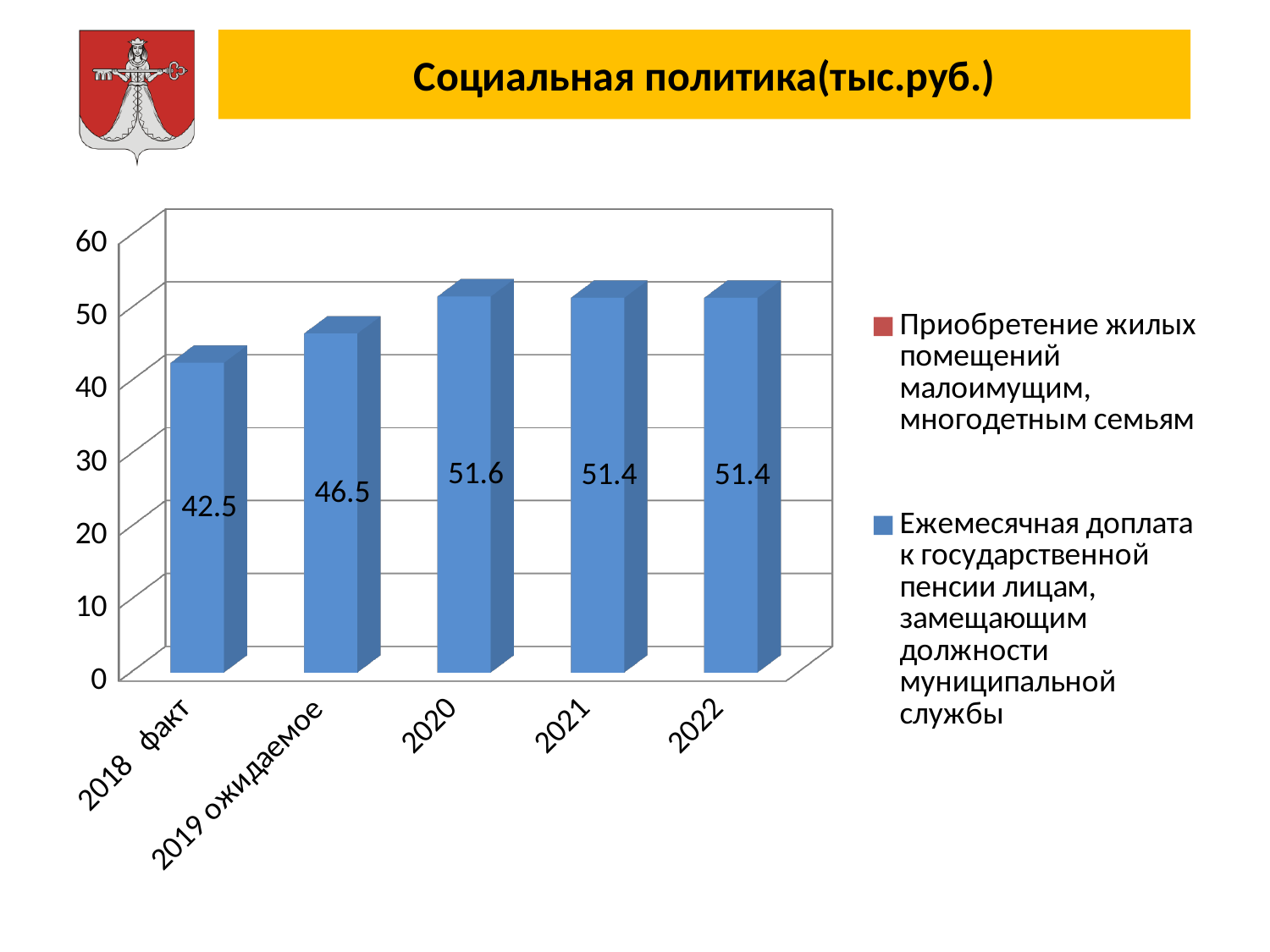
How many series does the legend list? 2 What is the value for 2019 ожидаемое? 46.5 What is the difference between the values for 2019 ожидаемое and 2018 факт? 4 What is the value for 2022? 51.4 Which is larger, the value for 2020 or the value for 2018 факт? 2020 Which category has the lowest value? 2018 факт How many categories are shown on the x axis? 5 Is the value for 2018 факт greater or less than 50? less Which category has the highest value? 2020 What kind of chart is shown on the slide? bar chart What is the value for 2018 факт? 42.5 What is the value for 2020? 51.6